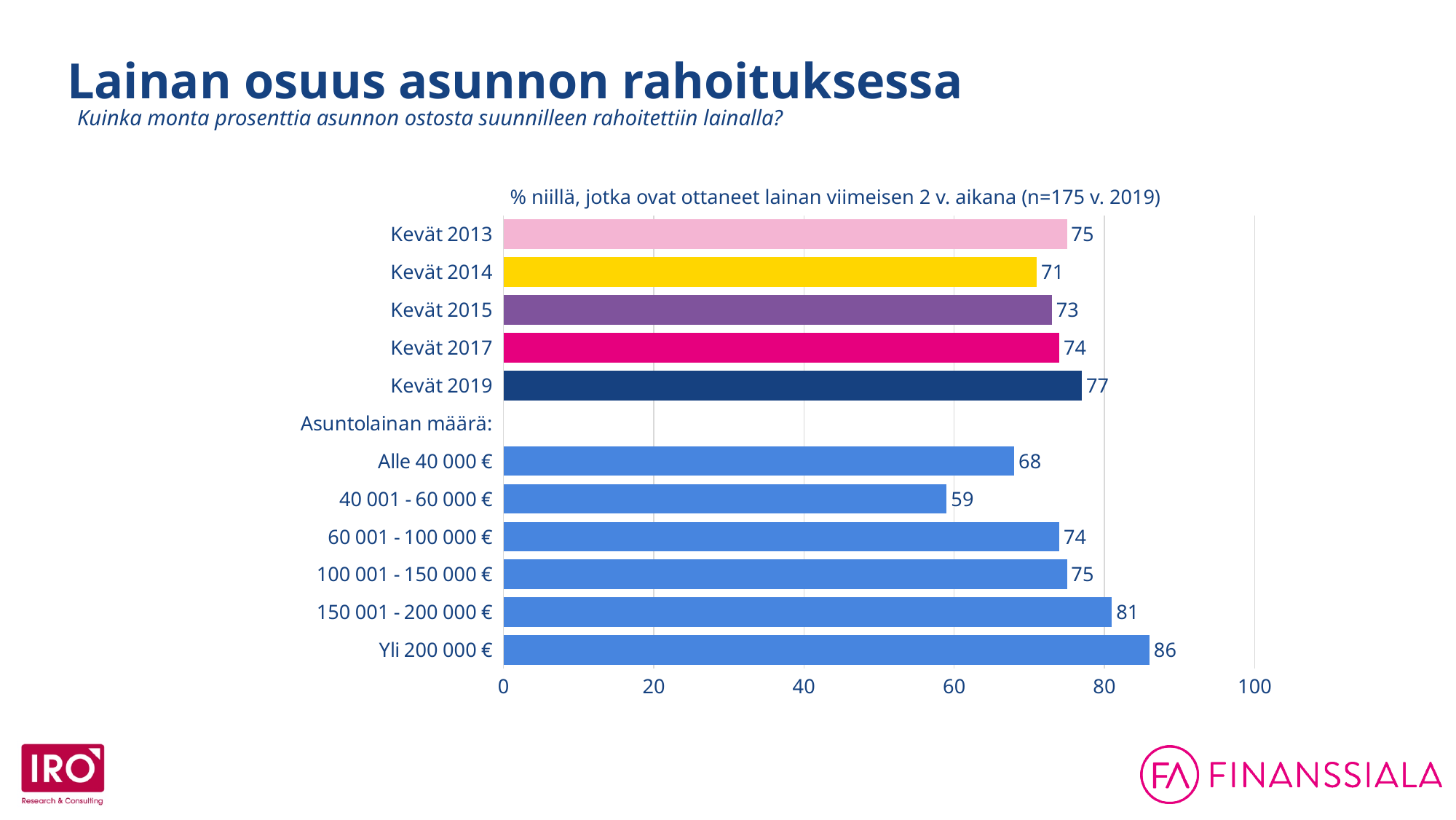
Which category has the highest value on the chart? Yli 200 000 € What is the value for Kevät 2019? 77 What is the difference between the values for Kevät 2019 and Kevät 2013? 2 Is the value for Kevät 2015 greater or less than 60? greater What kind of chart is shown on the slide? bar chart Do the values rise or fall as the loan amount categories increase from 40 001 - 60 000 € to Yli 200 000 €? rise Which category has the lowest value on the chart? 40 001 - 60 000 € What is the value for the 40 001 - 60 000 € category? 59 How many bars are plotted on the chart? 11 What is the difference between the values for Yli 200 000 € and Alle 40 000 €? 18 What is the value for Kevät 2014? 71 Which is larger, the value for 150 001 - 200 000 € or the value for 100 001 - 150 000 €? 150 001 - 200 000 €